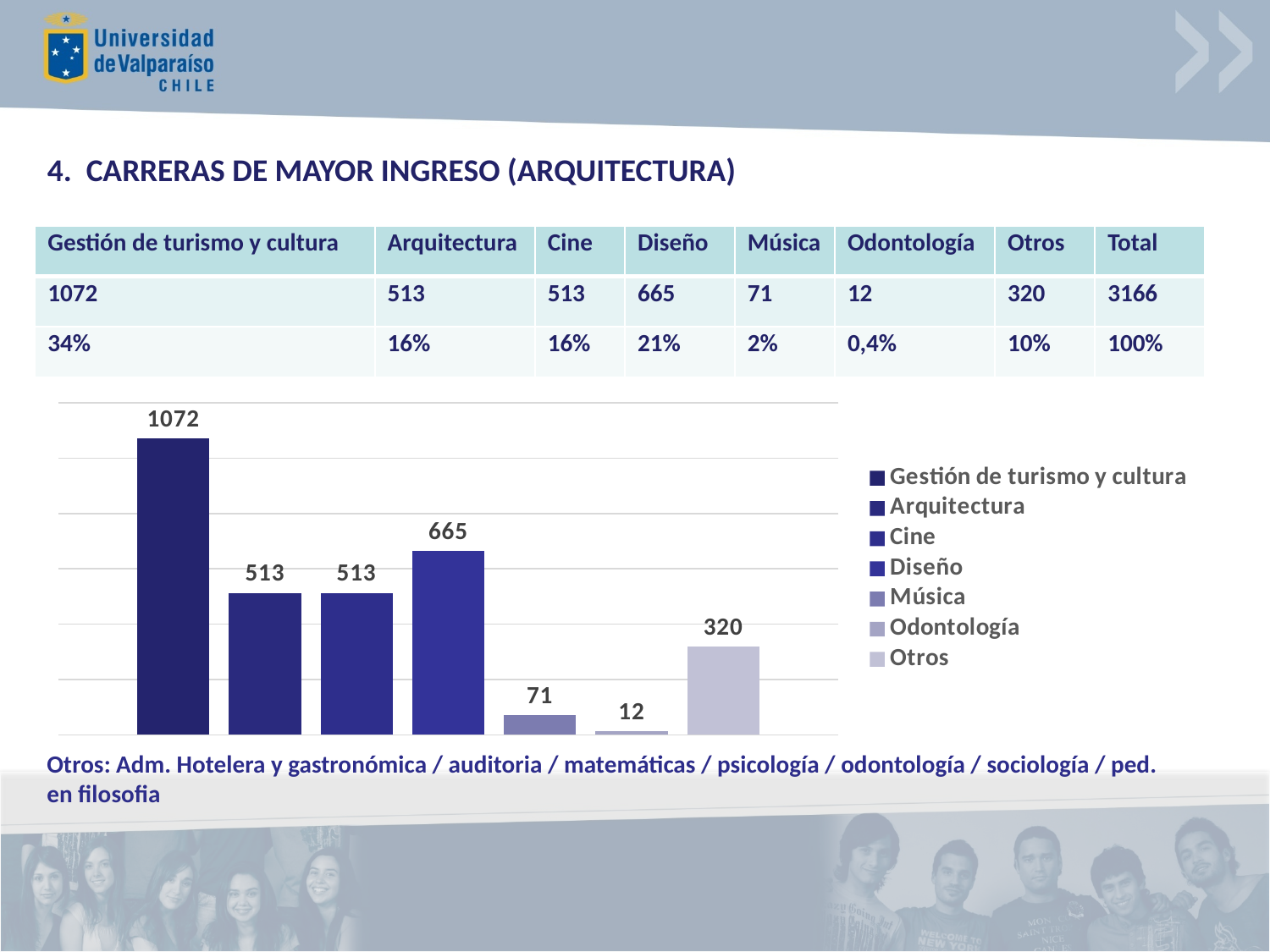
What is the difference between the values for Diseño and Arquitectura? 152 What type of chart is shown on the slide? bar chart Which category has the highest value in the chart? Gestión de turismo y cultura What is the value shown for Otros in the chart? 320 Which is larger, the value for Otros or the value for Música? Otros What is the value shown for Diseño in the chart? 665 Which category has the lowest value in the chart? Odontología What is the value shown for Odontología in the chart? 12 How many bars are plotted in the chart? 7 What is the difference between the values for Gestión de turismo y cultura and Diseño? 407 How many entries does the chart legend list? 7 What is the value shown for Gestión de turismo y cultura in the chart? 1072